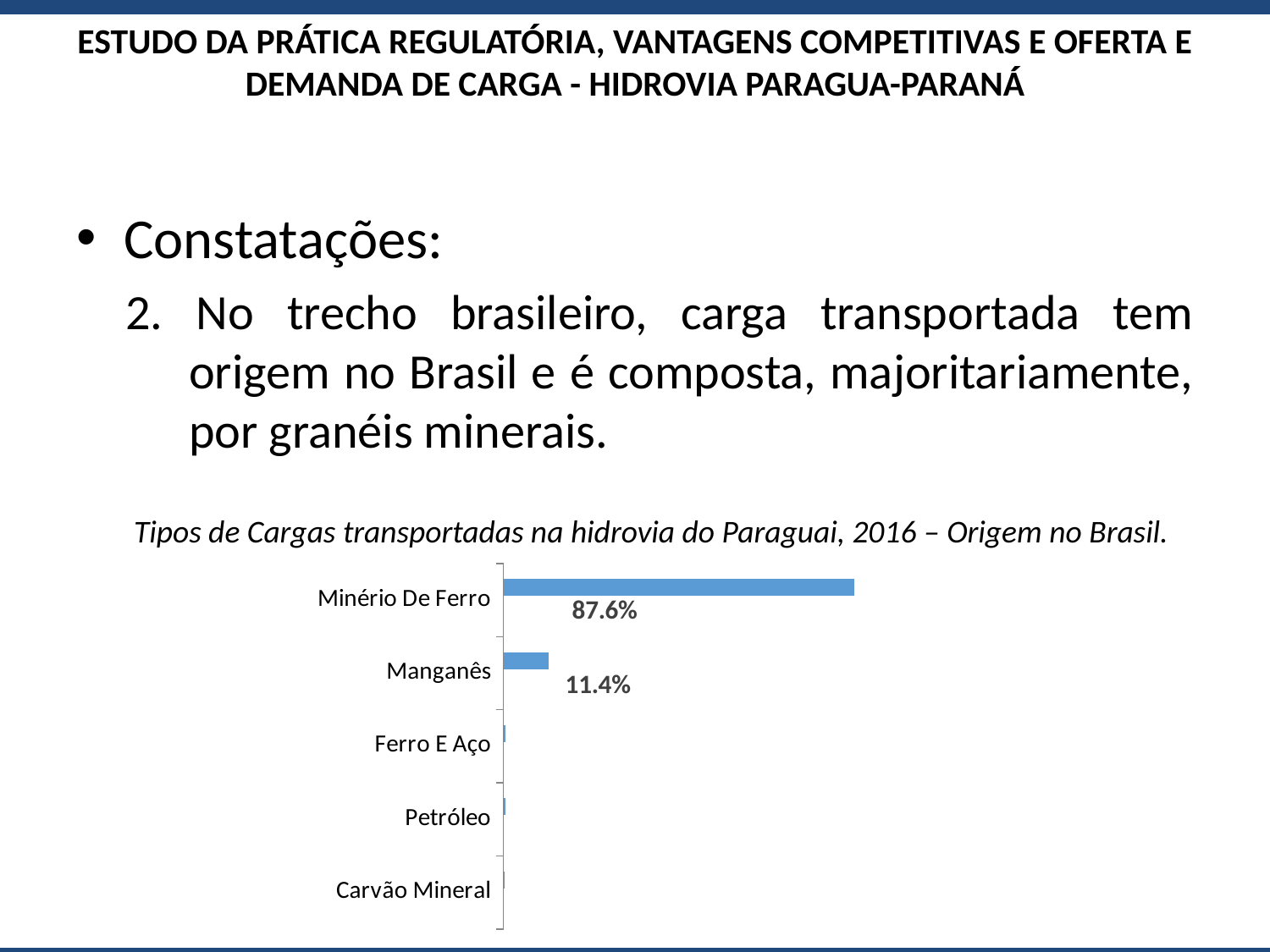
What is the value for Manganês? 11.4% Which is larger, the value for Minério De Ferro or the value for Manganês? Minério De Ferro How many cargo types are shown in the chart? 5 What colour are the bars in the chart? Blue What kind of chart is shown on the slide? Bar chart What is the title of the chart? Tipos de Cargas transportadas na hidrovia do Paraguai, 2016 – Origem no Brasil. Which is larger, the value for Manganês or the value for Ferro E Aço? Manganês Which cargo type has the lowest share? Carvão Mineral Which cargo type has the highest share? Minério De Ferro What is the difference between the values for Minério De Ferro and Manganês? 76.2% What is the value for Minério De Ferro? 87.6%